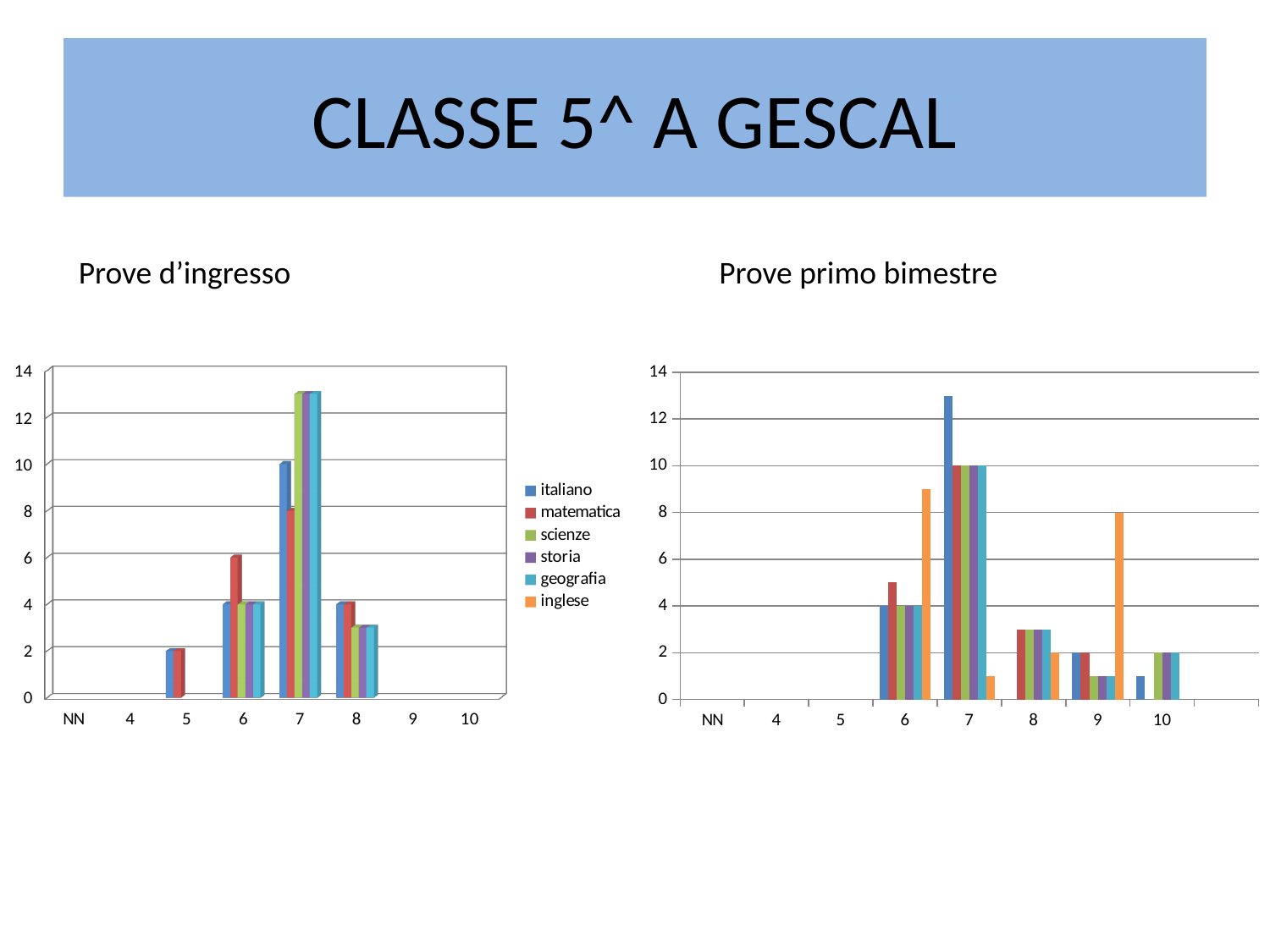
In the 'Prove primo bimestre' chart, what is the value for matematica at grade 7? 10 In the 'Prove d'ingresso' chart, what is the value for matematica at grade 6? 6 In the 'Prove d'ingresso' chart, is the value for scienze at grade 7 greater or less than 12? greater In the 'Prove primo bimestre' chart, what is the value for inglese at grade 9? 8 In the 'Prove primo bimestre' chart, is the value for italiano at grade 7 greater or less than 12? greater In the 'Prove d'ingresso' chart, what is the value for matematica at grade 7? 8 How many categories are shown on the x axis of the 'Prove primo bimestre' chart? 8 How many series does the legend list? 6 In the 'Prove d'ingresso' chart, what is the value for italiano at grade 7? 10 In the 'Prove primo bimestre' chart, at grade 6, which is larger: inglese or matematica? inglese What kind of chart is the 'Prove d'ingresso' chart on the left? bar chart In the 'Prove d'ingresso' chart, which grade category has the tallest bars? 7